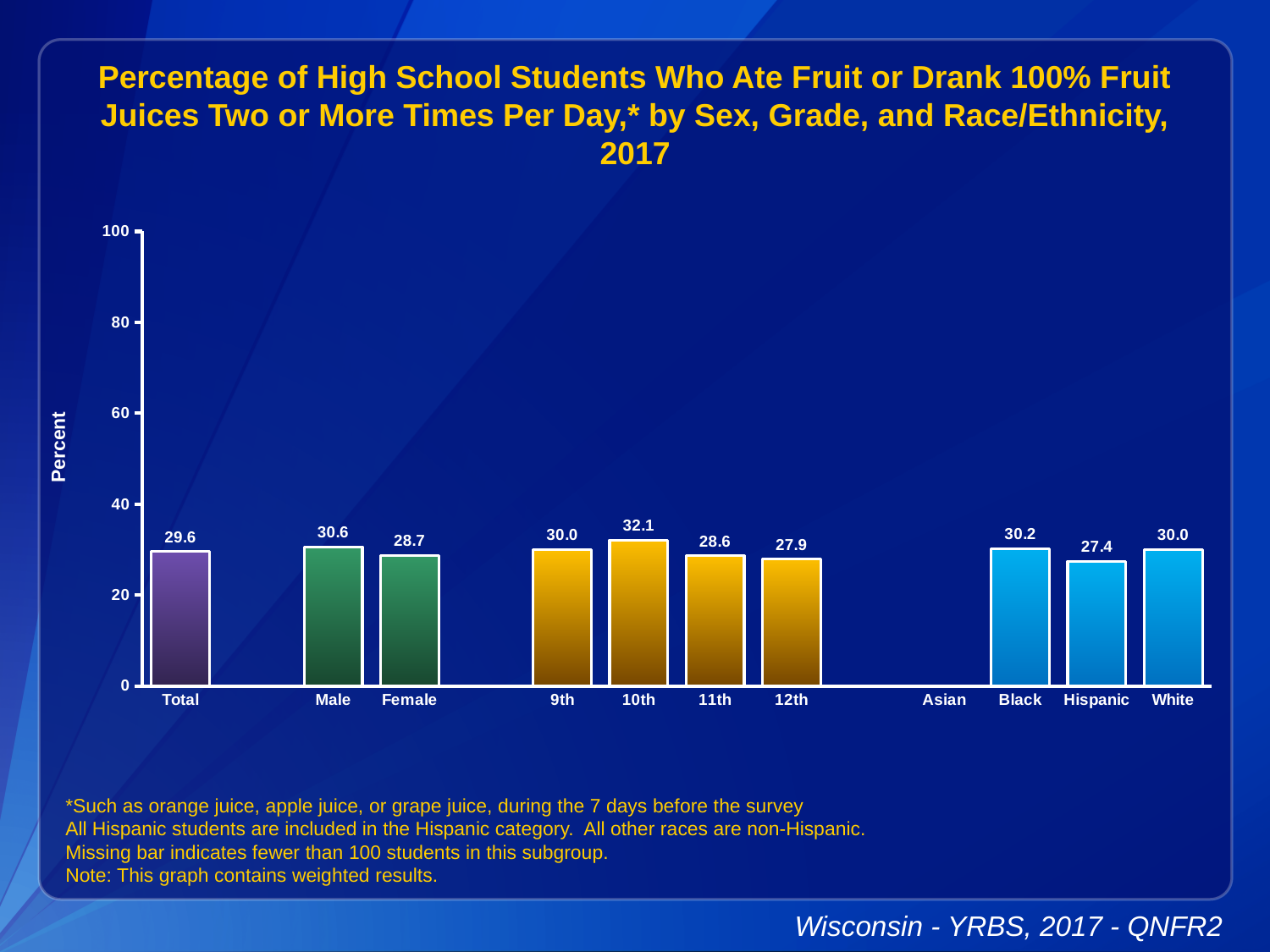
What is the difference between the Male and Female values? 1.9 What is the value for Hispanic? 27.4 Which category has the highest value? 10th Which is larger, the value for Black or the value for White? Black What kind of chart is shown? bar chart What is the value for Female? 28.7 How many categories have a bar plotted? 10 What is the value for Total? 29.6 Which category has the lowest value among those with a bar shown? Hispanic What is the value for 10th grade? 32.1 Which category has no bar shown? Asian Is the value for 12th grade greater or less than 40? less